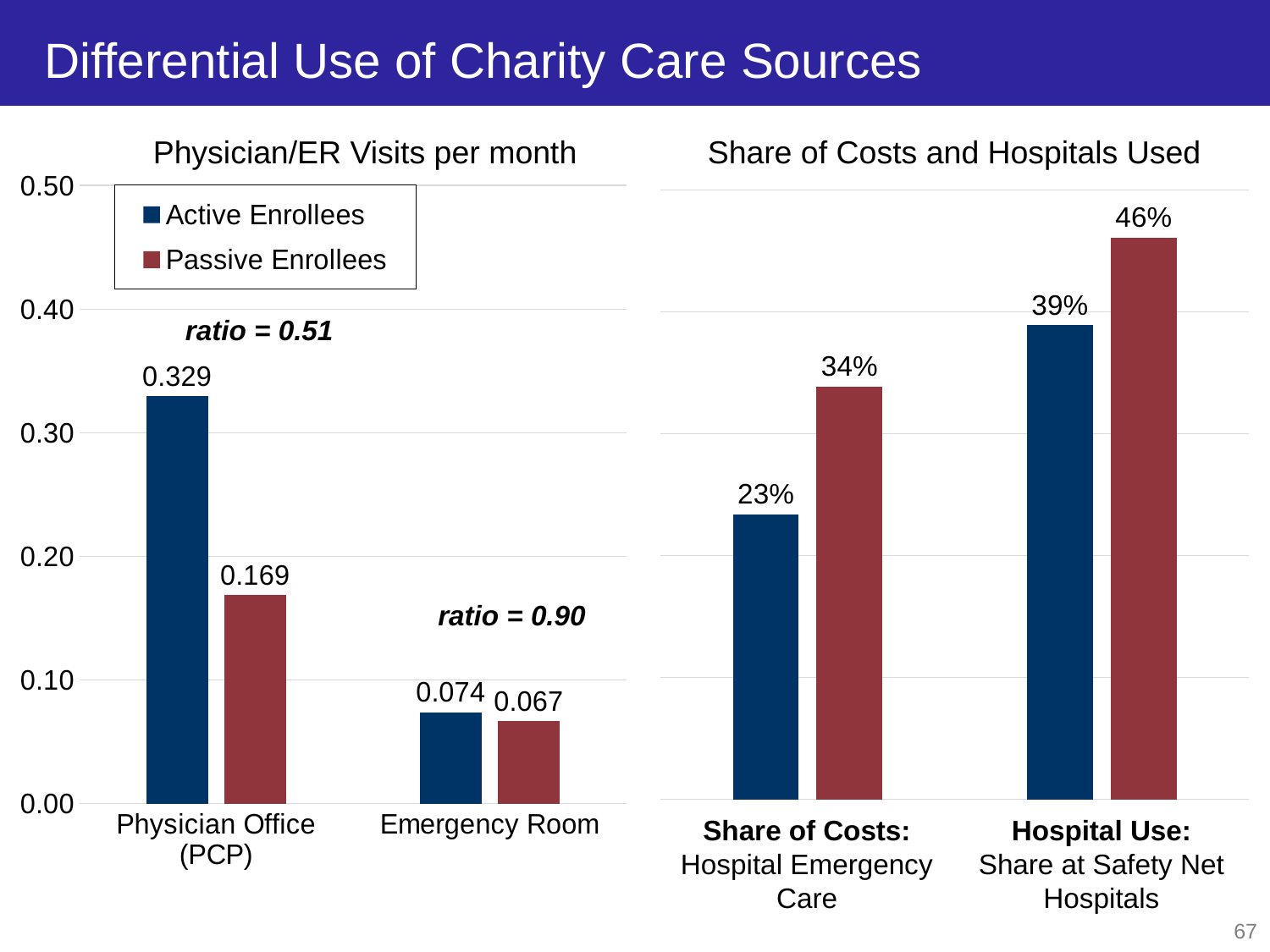
In the 'Share of Costs and Hospitals Used' chart, which bar is the highest? Passive Enrollees, Hospital Use: Share at Safety Net Hospitals (46%) In the 'Physician/ER Visits per month' chart, which is larger at Emergency Room: Active Enrollees or Passive Enrollees? Active Enrollees In the 'Physician/ER Visits per month' chart, what is the value for Active Enrollees at Physician Office (PCP)? 0.329 What kind of chart is the 'Share of Costs and Hospitals Used' chart? Bar chart In the 'Physician/ER Visits per month' chart, what is the value for Passive Enrollees at Emergency Room? 0.067 In the 'Share of Costs and Hospitals Used' chart, what is the Passive Enrollees value for Share of Costs: Hospital Emergency Care? 34% In the 'Share of Costs and Hospitals Used' chart, what is the difference between Passive Enrollees and Active Enrollees for Share of Costs: Hospital Emergency Care? 11% In the 'Share of Costs and Hospitals Used' chart, how many categories are shown on the x axis? 2 In the 'Physician/ER Visits per month' chart, what is the difference between Active Enrollees and Passive Enrollees at Physician Office (PCP)? 0.160 In the 'Physician/ER Visits per month' chart, what ratio is shown for Physician Office (PCP)? 0.51 In the 'Share of Costs and Hospitals Used' chart, what is the Active Enrollees value for Hospital Use: Share at Safety Net Hospitals? 39% In the 'Physician/ER Visits per month' chart, how many series does the legend list? 2